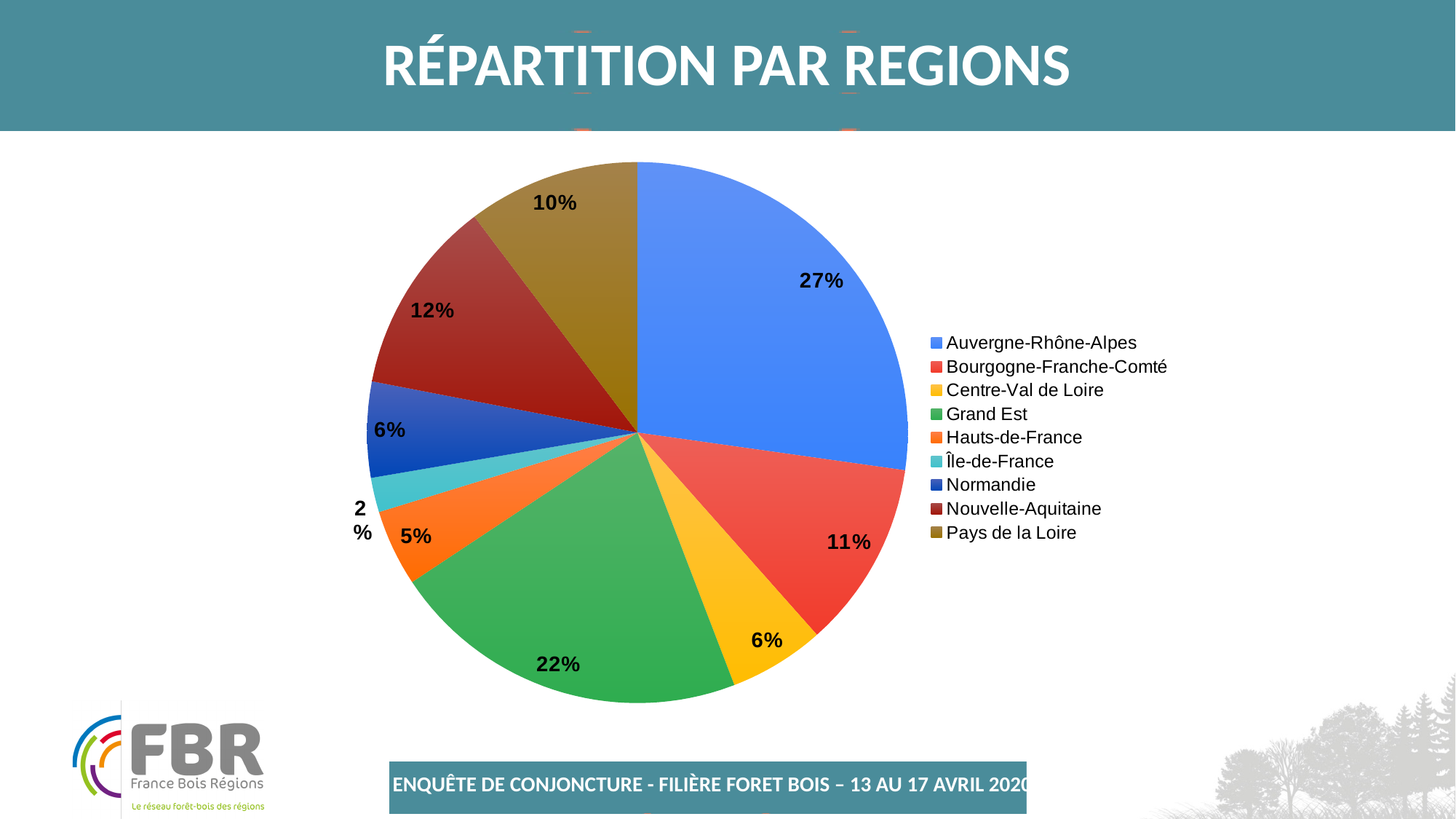
What is the value shown for Pays de la Loire? 10% What is the difference between the shares of Auvergne-Rhône-Alpes and Grand Est? 5% What kind of chart is shown on the slide? pie chart What share of the pie does Grand Est have? 22% What is the title of the slide containing the pie chart? RÉPARTITION PAR REGIONS Which region has the smallest slice of the pie? Île-de-France Which region has the largest slice of the pie? Auvergne-Rhône-Alpes What is the value shown for Nouvelle-Aquitaine? 12% What is the value shown for Hauts-de-France? 5% How many regions are listed in the legend of the pie chart? 9 What share of the pie does Auvergne-Rhône-Alpes have? 27% Which is larger, the share for Bourgogne-Franche-Comté or the share for Nouvelle-Aquitaine? Nouvelle-Aquitaine